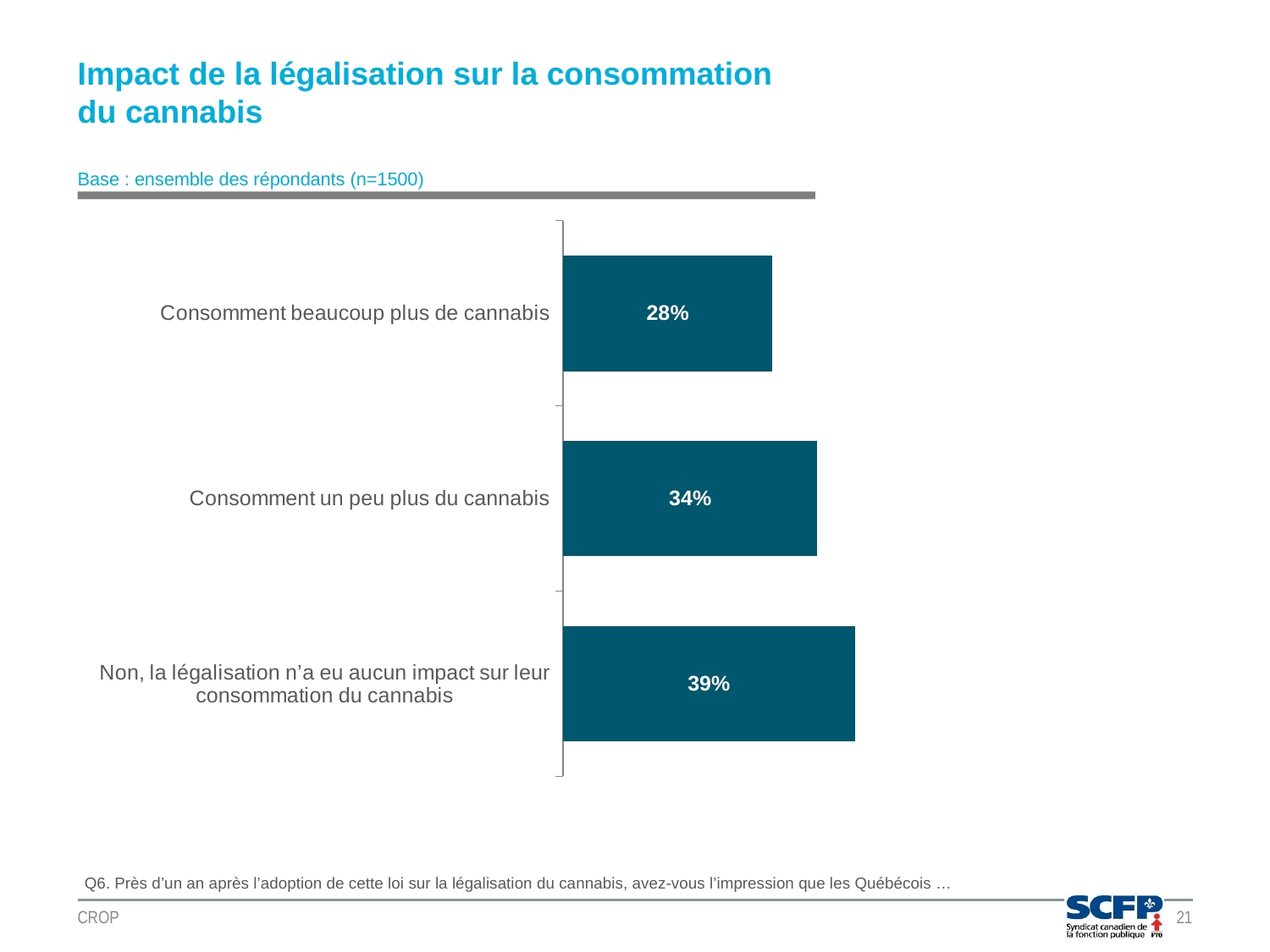
What is the value for "Consomment beaucoup plus de cannabis"? 28% Which category has the highest value? Non, la légalisation n'a eu aucun impact sur leur consommation du cannabis Which is larger: the value for "Consomment un peu plus du cannabis" or "Consomment beaucoup plus de cannabis"? Consomment un peu plus du cannabis What is the difference between the values for "Non, la légalisation n'a eu aucun impact sur leur consommation du cannabis" and "Consomment beaucoup plus de cannabis"? 11% Which category has the lowest value? Consomment beaucoup plus de cannabis How many categories are shown in the chart? 3 What is the base (sample size) stated for the chart? ensemble des répondants (n=1500) What is the value for "Consomment un peu plus du cannabis"? 34% What is the difference between the values for "Consomment un peu plus du cannabis" and "Consomment beaucoup plus de cannabis"? 6% What is the title of the slide? Impact de la légalisation sur la consommation du cannabis What is the value for "Non, la légalisation n'a eu aucun impact sur leur consommation du cannabis"? 39% What kind of chart is shown on the slide? Bar chart